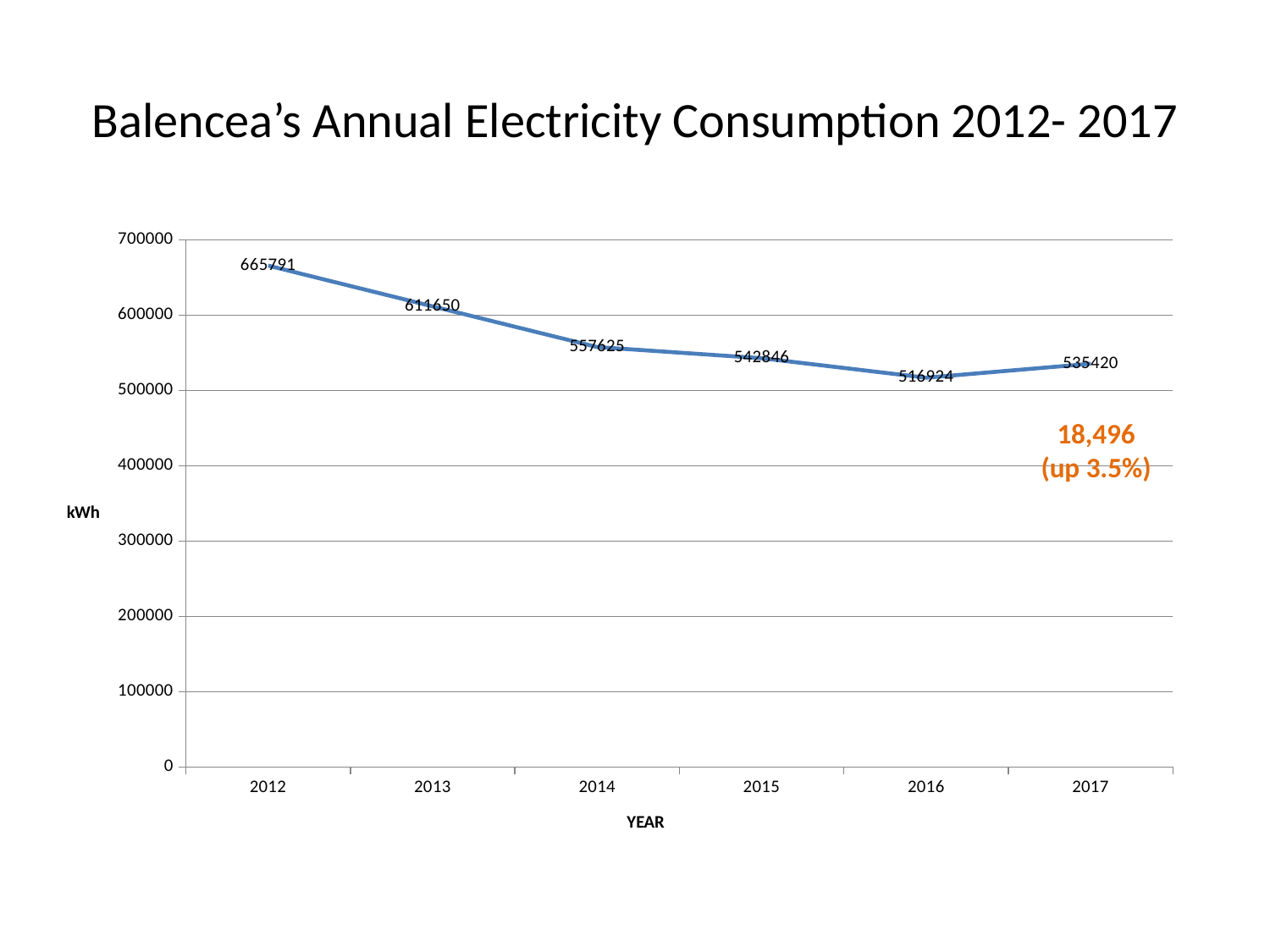
Which year had higher consumption, 2014 or 2015? 2014 What was the electricity consumption in 2017? 535420 Which year had the lowest electricity consumption? 2016 What is the label on the vertical axis? kWh What was the electricity consumption in 2016? 516924 What is the difference in consumption between 2017 and 2016? 18496 What is the difference in consumption between 2012 and 2013? 54141 What was Balencea's electricity consumption in 2012? 665791 How many years are plotted on the chart? 6 Is the value for 2013 greater or less than 600000? greater What kind of chart is shown on the slide? line chart Which year had the highest electricity consumption? 2012